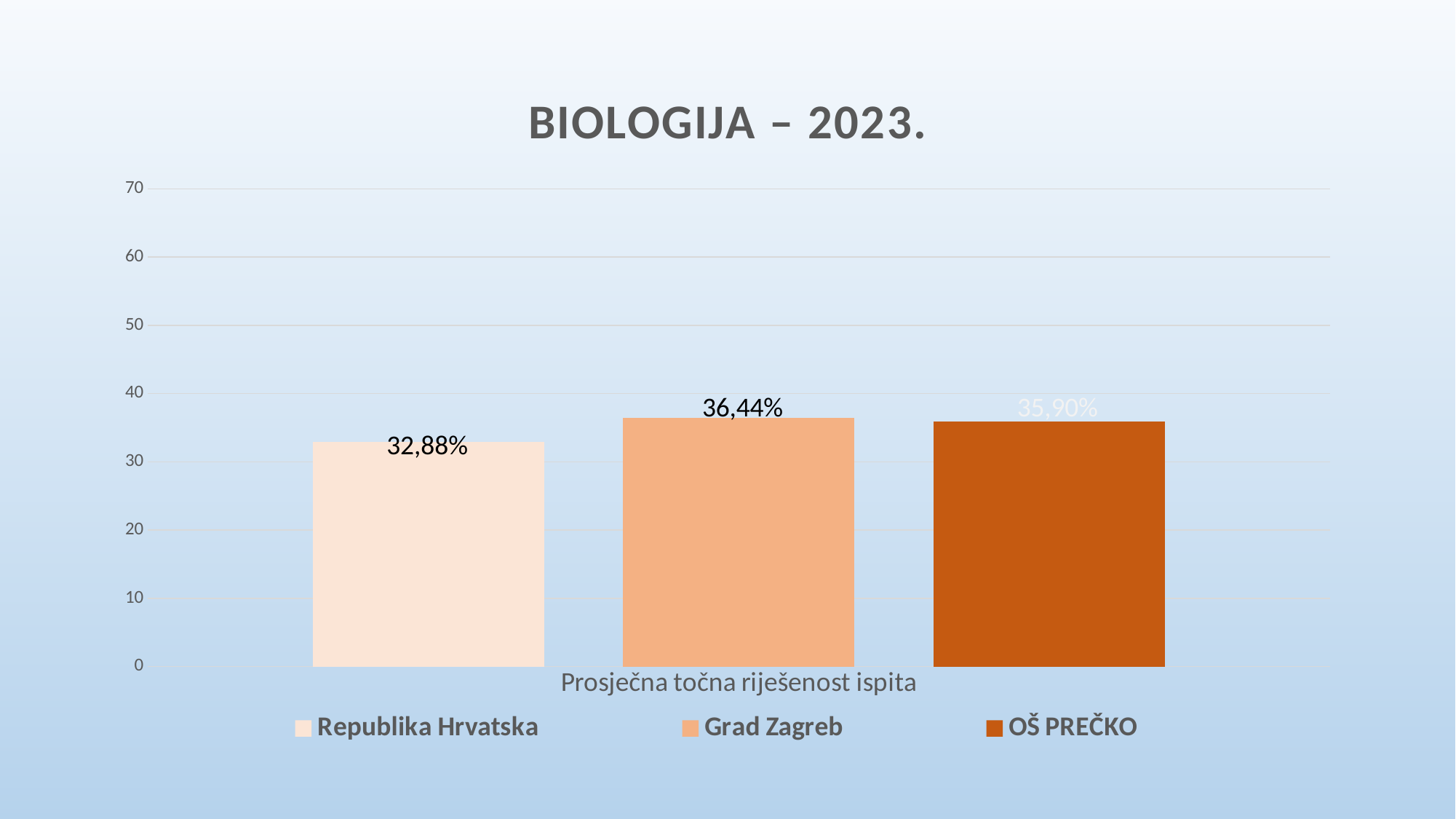
How many series does the legend list? 3 Which series has the lowest value? Republika Hrvatska Which is larger, the value for Grad Zagreb or the value for OŠ PREČKO? Grad Zagreb What is the difference between the values for OŠ PREČKO and Republika Hrvatska? 3,02% What kind of chart is shown on the slide? bar chart What is the difference between the values for Grad Zagreb and Republika Hrvatska? 3,56% Is the value for Republika Hrvatska greater or less than 40? less What is the value for OŠ PREČKO? 35,90% What is the value for Republika Hrvatska? 32,88% Which series has the highest value? Grad Zagreb What is the title of the chart? BIOLOGIJA – 2023. What is the value for Grad Zagreb? 36,44%